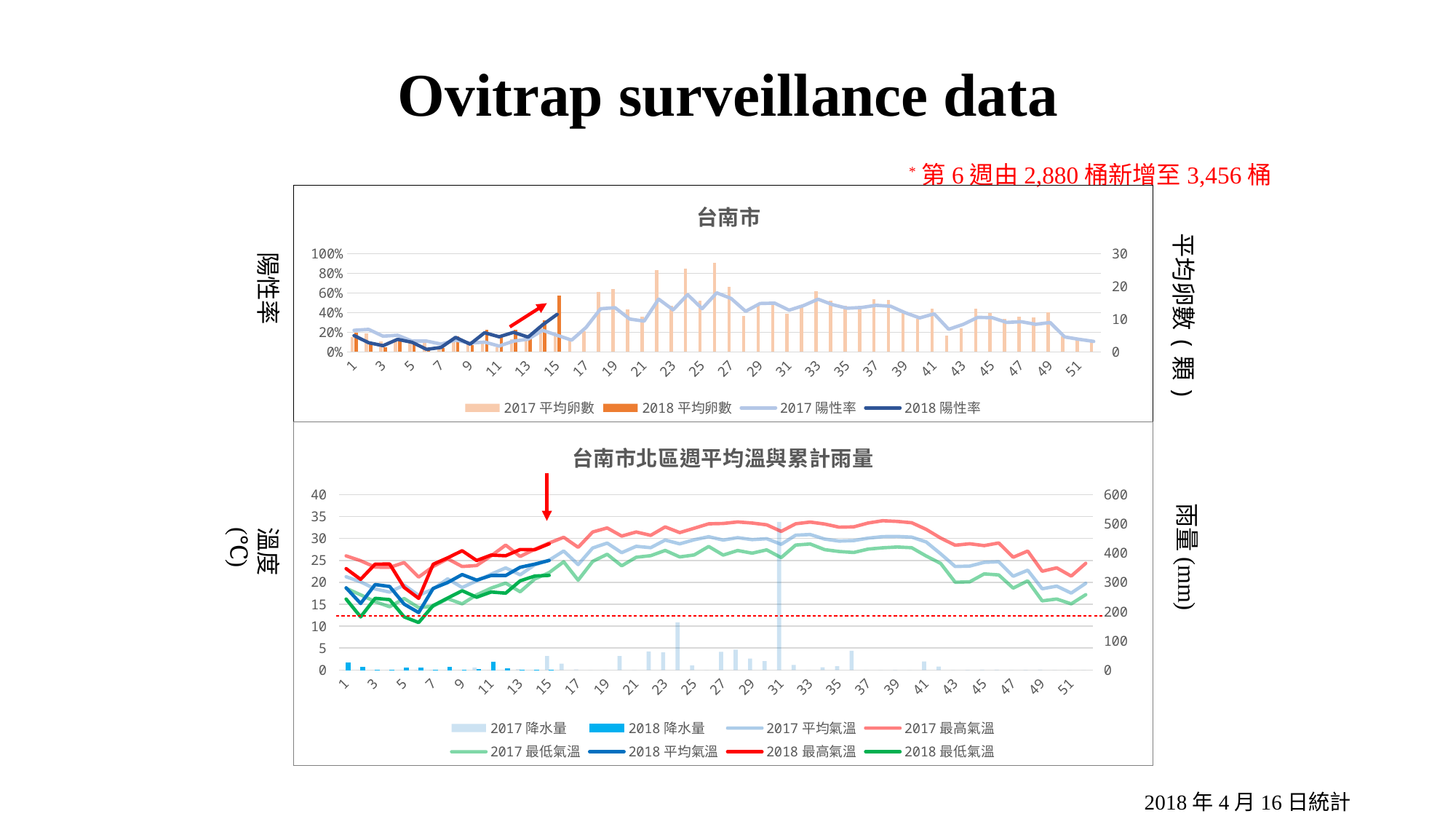
In the top chart (台南市), at which week is the 2017 平均卵數 bar the tallest? 26 In the bottom chart (台南市北區週平均溫與累計雨量), does the 2018 最高氣溫 line rise or fall from week 7 to week 15? rise How many series does the legend of the top chart (台南市) list? 4 In the top chart (台南市), is the 2018 平均卵數 value at week 15 greater or less than 10? greater How many series does the legend of the bottom chart (台南市北區週平均溫與累計雨量) list? 8 In the top chart (台南市), what is the maximum value shown on the left vertical axis? 100% What kind of chart is the top chart titled 台南市? Combined bar and line chart What is the title of the bottom chart? 台南市北區週平均溫與累計雨量 In the bottom chart (台南市北區週平均溫與累計雨量), at which week is the 2017 降水量 bar the tallest? 31 In the bottom chart (台南市北區週平均溫與累計雨量), is the 2017 最高氣溫 value at week 31 greater or less than 30? greater In the top chart (台南市), is the 2017 陽性率 value at week 26 greater or less than 40%? greater